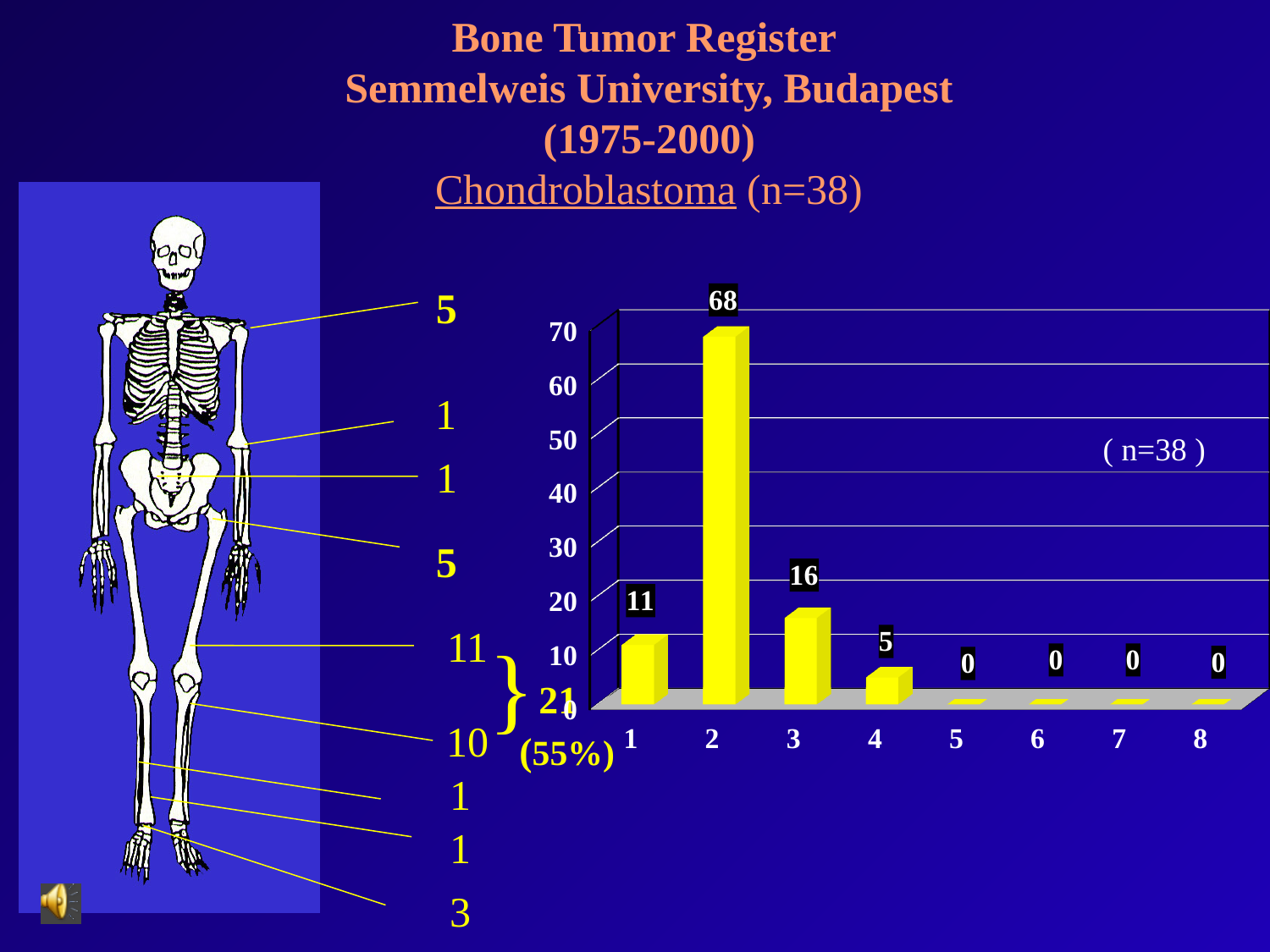
What is the value for category 4 in the bar chart? 5 What is the difference between the values for category 2 and category 3? 52 What is the value for category 3 in the bar chart? 16 Which category has the highest value in the bar chart? 2 Which is larger, the value for category 1 or the value for category 3? category 3 How many categories are shown on the x axis of the bar chart? 8 How many categories in the bar chart have a value of 0? 4 What is the value for category 2 in the bar chart? 68 What sample size is printed inside the chart area? ( n=38 ) What is the value for category 1 in the bar chart? 11 What kind of chart is shown on the slide? bar chart What is the difference between the values for category 3 and category 1? 5